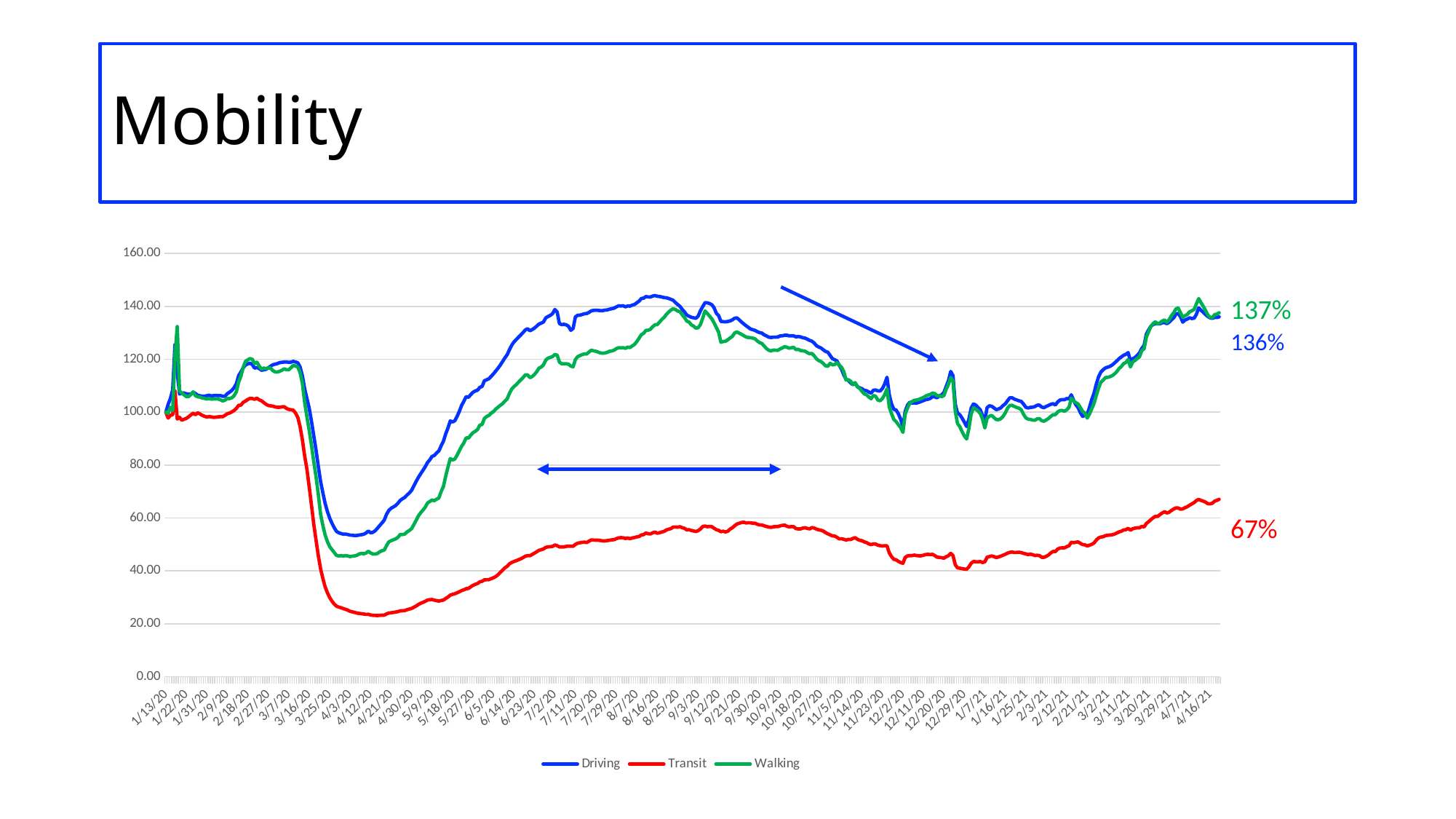
What is the final labelled value for the Transit series? 67% What colour is the Transit line in the legend? Red How many series does the legend list? 3 Is the value for Transit around 4/3/20 greater or less than 40? less What is the difference between the final labelled values for Walking and Transit? 70 percentage points What is the final labelled value for the Walking series? 137% At the end of the chart, which labelled value is larger: Driving or Transit? Driving Which series has the highest labelled value at the end of the chart? Walking Does the Transit line rise or fall between 3/7/20 and 4/3/20? Falls What is the final labelled value for the Driving series? 136% Which series has the lowest labelled value at the end of the chart? Transit What kind of chart is shown on the slide? Line chart